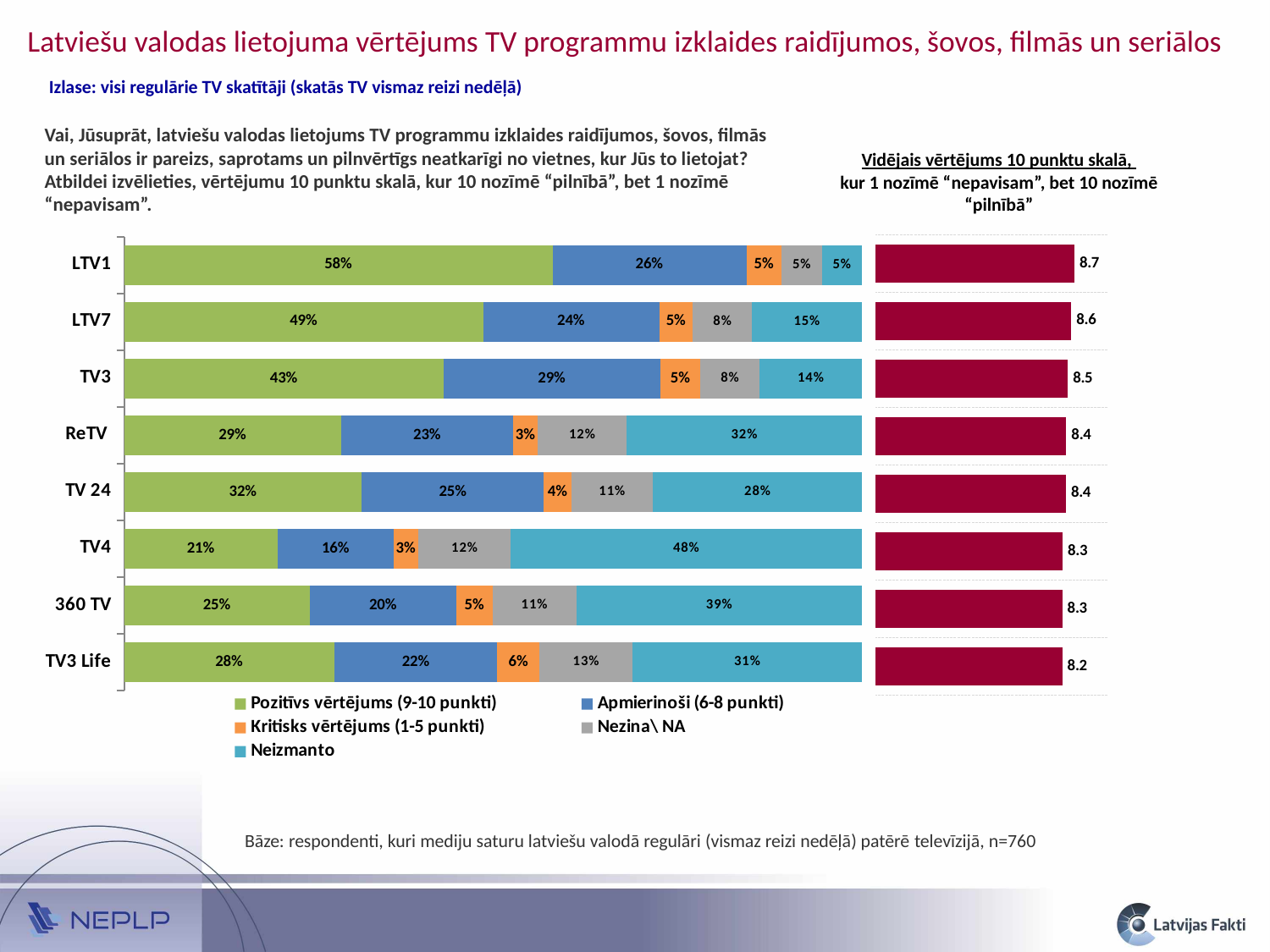
In the stacked bar chart on the left, how much larger is the positive rating share for LTV7 than for TV3? 6% How many series does the legend of the stacked bar chart on the left list? 5 In the average rating chart on the right, which channel has the lowest average rating? TV3 Life In the stacked bar chart on the left, what is the Neizmanto share for ReTV? 32% In the stacked bar chart on the left, what percentage of LTV1 viewers gave a positive rating (Pozitīvs vērtējums, 9-10 punkti)? 58% In the average rating chart on the right, which channel has the highest average rating? LTV1 In the average rating chart on the right (Vidējais vērtējums 10 punktu skalā), what is the value for TV3? 8.5 What kind of chart is the chart on the left? Stacked bar chart In the stacked bar chart on the left, which channel has a larger Neizmanto share, TV4 or 360 TV? TV4 In the stacked bar chart on the left, what colour represents Pozitīvs vērtējums (9-10 punkti)? Green In the average rating chart on the right, what is the difference between the values for LTV1 and TV3 Life? 0.5 In the stacked bar chart on the left, how many channels are shown? 8